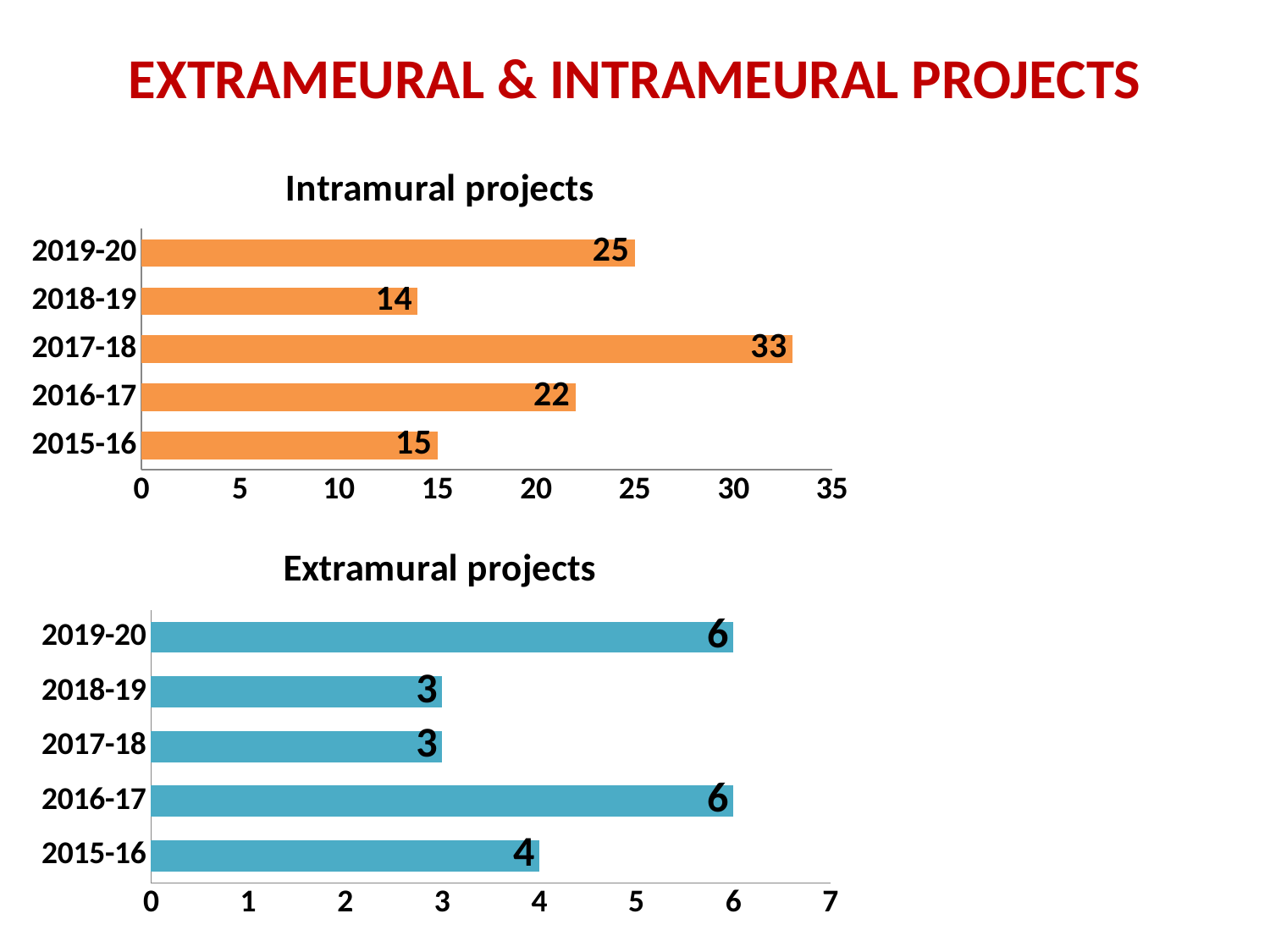
In the Intramural projects chart, which year has the lowest value? 2018-19 In the Intramural projects chart, which year has the highest value? 2017-18 In the Extramural projects chart, what is the difference between the values for 2019-20 and 2018-19? 3 In the Extramural projects chart, what is the value for 2015-16? 4 In the Intramural projects chart, what is the value for 2018-19? 14 In the Intramural projects chart, what is the difference between the values for 2019-20 and 2015-16? 10 What colour are the bars in the Intramural projects chart? orange What kind of chart is the Extramural projects chart? bar chart In the Intramural projects chart, what is the value for 2017-18? 33 How many years are shown in the Extramural projects chart? 5 In the Intramural projects chart, which is larger, the value for 2016-17 or the value for 2019-20? 2019-20 In the Intramural projects chart, is the value for 2017-18 greater or less than 30? greater